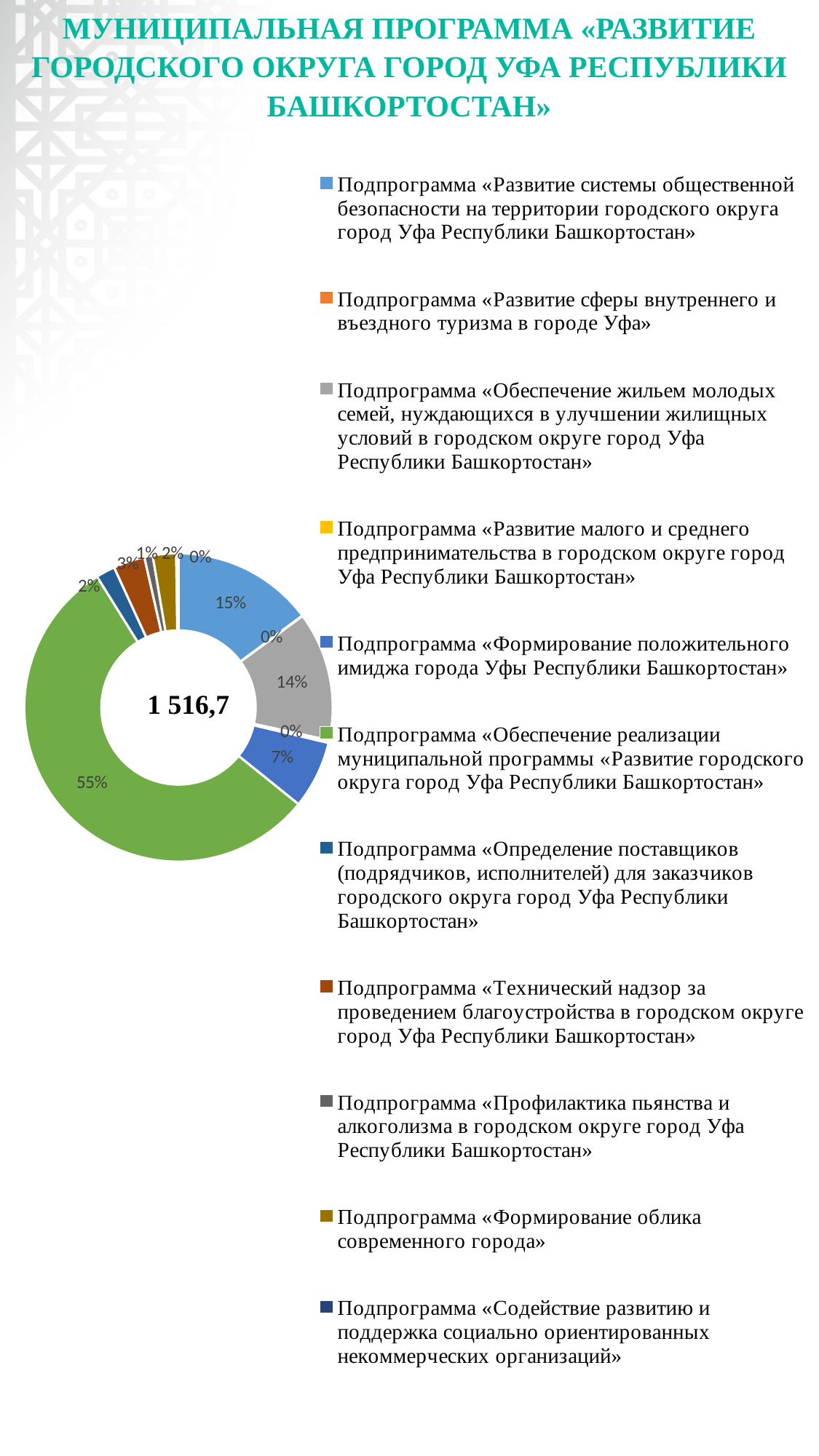
What colour is the largest slice of the doughnut chart? green By how many percentage points does the share of «Обеспечение реализации муниципальной программы...» exceed the share of «Развитие системы общественной безопасности...»? 40 percentage points What share of the chart does the subprogramme «Технический надзор за проведением благоустройства...» have? 3% What share of the chart does the subprogramme «Формирование положительного имиджа города Уфы...» have? 7% What share of the chart does the subprogramme «Обеспечение реализации муниципальной программы...» have? 55% What kind of chart is shown on the slide? doughnut (pie) chart Which subprogramme has the largest share of the doughnut chart? Подпрограмма «Обеспечение реализации муниципальной программы «Развитие городского округа город Уфа Республики Башкортостан» Which is larger: the share for «Развитие системы общественной безопасности...» or the share for «Обеспечение жильем молодых семей...»? «Развитие системы общественной безопасности...» (15%) How many subprogrammes does the legend of the chart list? 11 What value is printed in the centre of the doughnut chart? 1 516,7